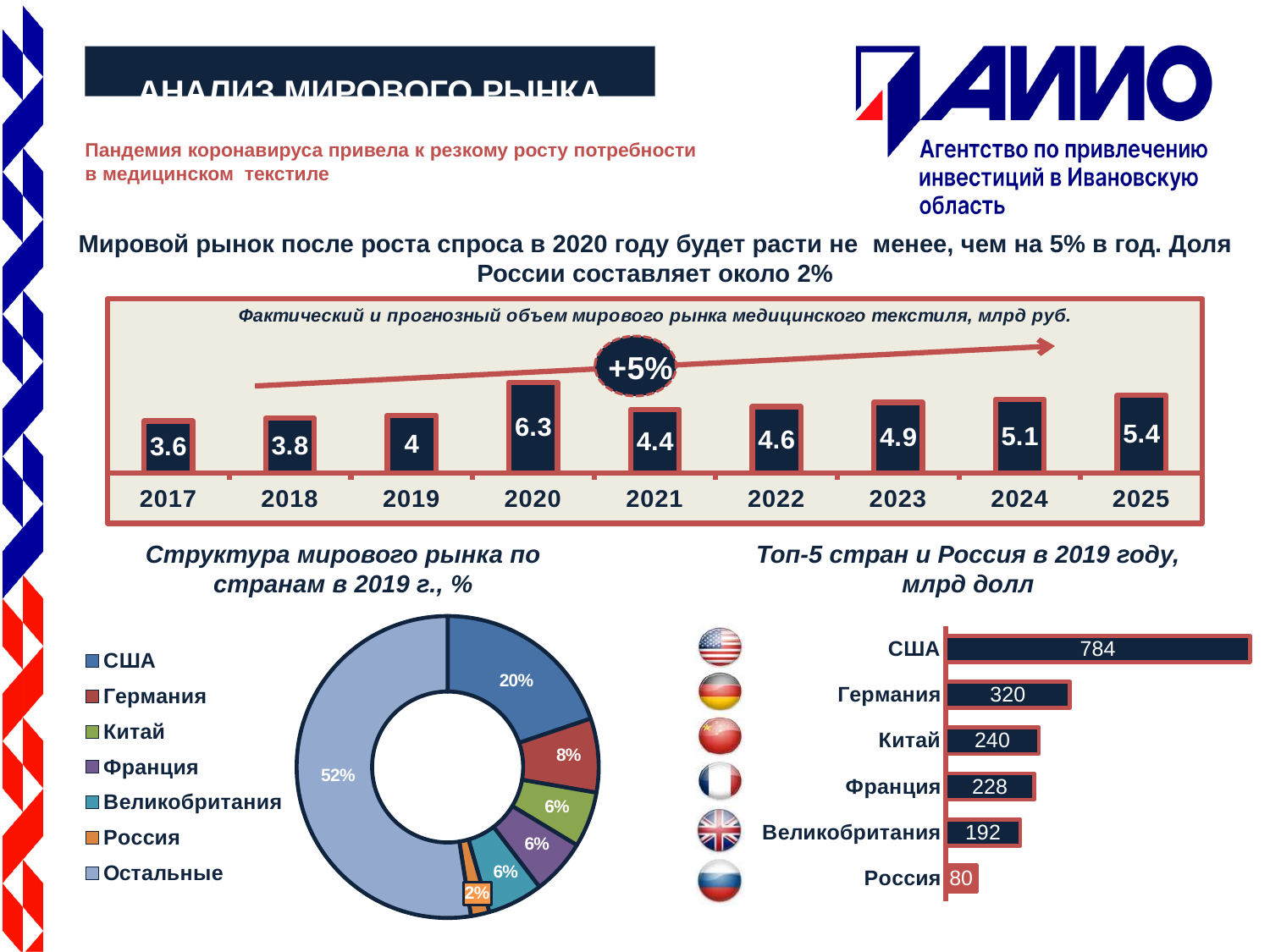
In the chart 'Фактический и прогнозный объем мирового рынка медицинского текстиля, млрд руб.', which year has the lowest value? 2017 In the chart 'Топ-5 стран и Россия в 2019 году, млрд долл', which is larger, the value for Франция or the value for Великобритания? Франция In the chart 'Фактический и прогнозный объем мирового рынка медицинского текстиля, млрд руб.', how many years are shown on the x axis? 9 What kind of chart is 'Структура мирового рынка по странам в 2019 г., %'? pie (donut) chart In the chart 'Топ-5 стран и Россия в 2019 году, млрд долл', what is the difference between the values for США and Германия? 464 In the chart 'Топ-5 стран и Россия в 2019 году, млрд долл', what is the value for Китай? 240 In the chart 'Структура мирового рынка по странам в 2019 г., %', how many categories does the legend list? 7 In the chart 'Структура мирового рынка по странам в 2019 г., %', what share does Германия have? 8% In the chart 'Фактический и прогнозный объем мирового рынка медицинского текстиля, млрд руб.', what is the difference between the values for 2025 and 2021? 1 In the chart 'Структура мирового рынка по странам в 2019 г., %', which category has the largest share? Остальные In the chart 'Фактический и прогнозный объем мирового рынка медицинского текстиля, млрд руб.', do the values rise or fall from 2021 to 2025? rise In the chart 'Фактический и прогнозный объем мирового рынка медицинского текстиля, млрд руб.', what is the value for 2020? 6.3